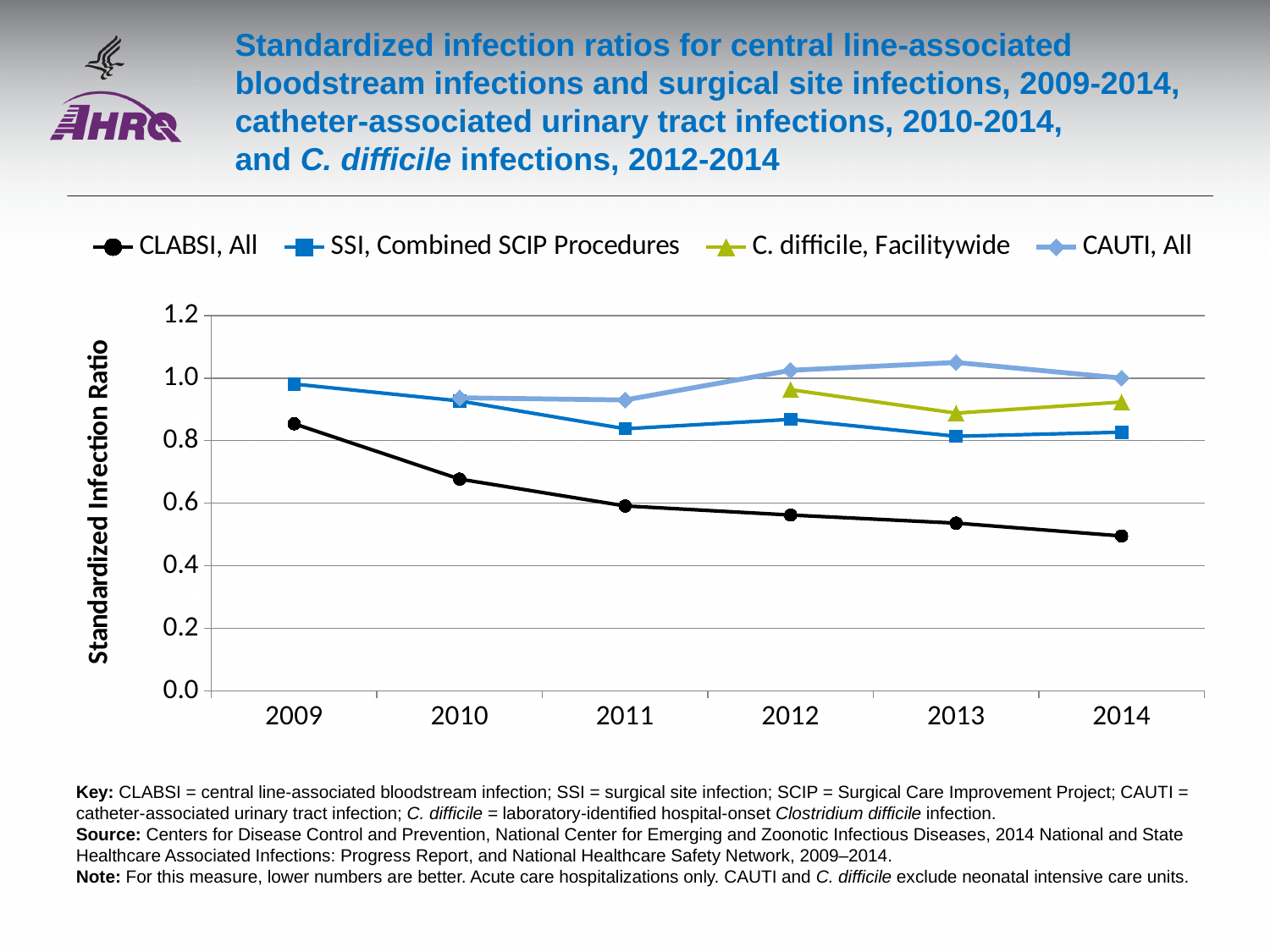
Which series has the lowest value in 2012? CLABSI, All What kind of chart is shown on the slide? line chart Is the value for CLABSI, All in 2009 greater or less than 0.8? greater Is the value for CAUTI, All in 2013 greater or less than 1.0? greater Is the value for SSI, Combined SCIP Procedures in 2011 greater or less than 1.0? less Which is larger for CLABSI, All: the value in 2009 or the value in 2014? 2009 What is the title of the y axis? Standardized Infection Ratio How many series does the legend list? 4 Which series has the highest value in 2014? CAUTI, All How many years are shown along the x axis? 6 Does the CLABSI, All series rise or fall from 2009 to 2014? fall